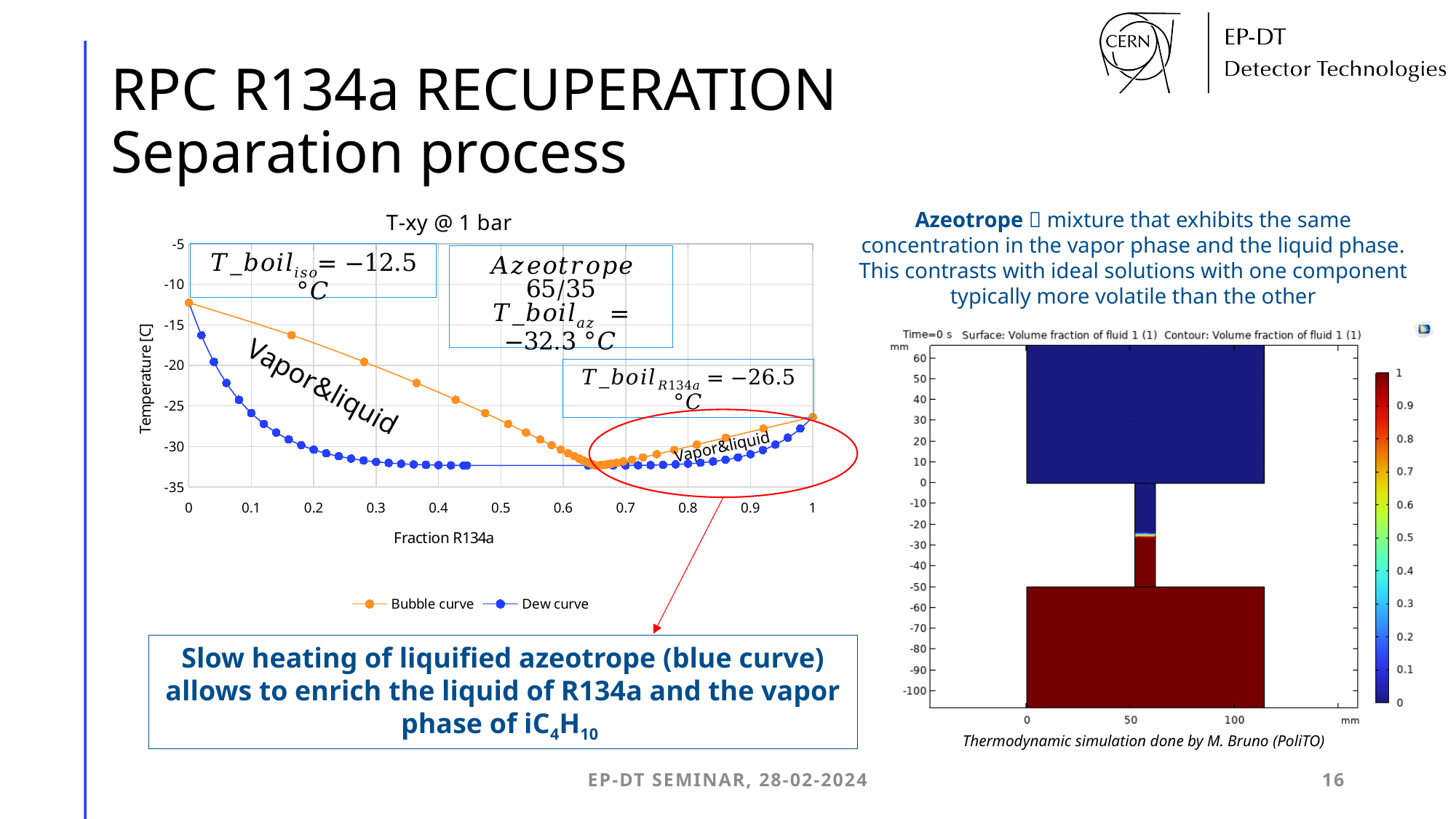
In the 'T-xy @ 1 bar' chart, what boiling temperature is given for the azeotrope (T_boil_az)? −32.3 °C In the 'T-xy @ 1 bar' chart, does the Bubble curve rise or fall as the fraction of R134a increases from 0 to 0.6? fall What is the title of the chart on the left of the slide? T-xy @ 1 bar In the 'T-xy @ 1 bar' chart, is the Dew curve value at fraction R134a = 0.4 greater or less than −30? less In the 'T-xy @ 1 bar' chart, what boiling temperature is given for R134a (T_boil_R134a)? −26.5 °C In the 'T-xy @ 1 bar' chart, is the Bubble curve value at fraction R134a = 0.2 greater or less than −20? greater What are the two series named in the legend of the 'T-xy @ 1 bar' chart? Bubble curve and Dew curve How many series does the legend of the 'T-xy @ 1 bar' chart list? 2 What kind of chart is the 'T-xy @ 1 bar' chart? line chart In the 'T-xy @ 1 bar' chart, what boiling temperature is given for T_boil_iso (at fraction R134a = 0)? −12.5 °C In the 'T-xy @ 1 bar' chart, which curve has the higher temperature at fraction R134a = 0.2, the Bubble curve or the Dew curve? Bubble curve In the 'T-xy @ 1 bar' chart, what is the difference between T_boil_iso (−12.5 °C) and T_boil_R134a (−26.5 °C)? 14 °C